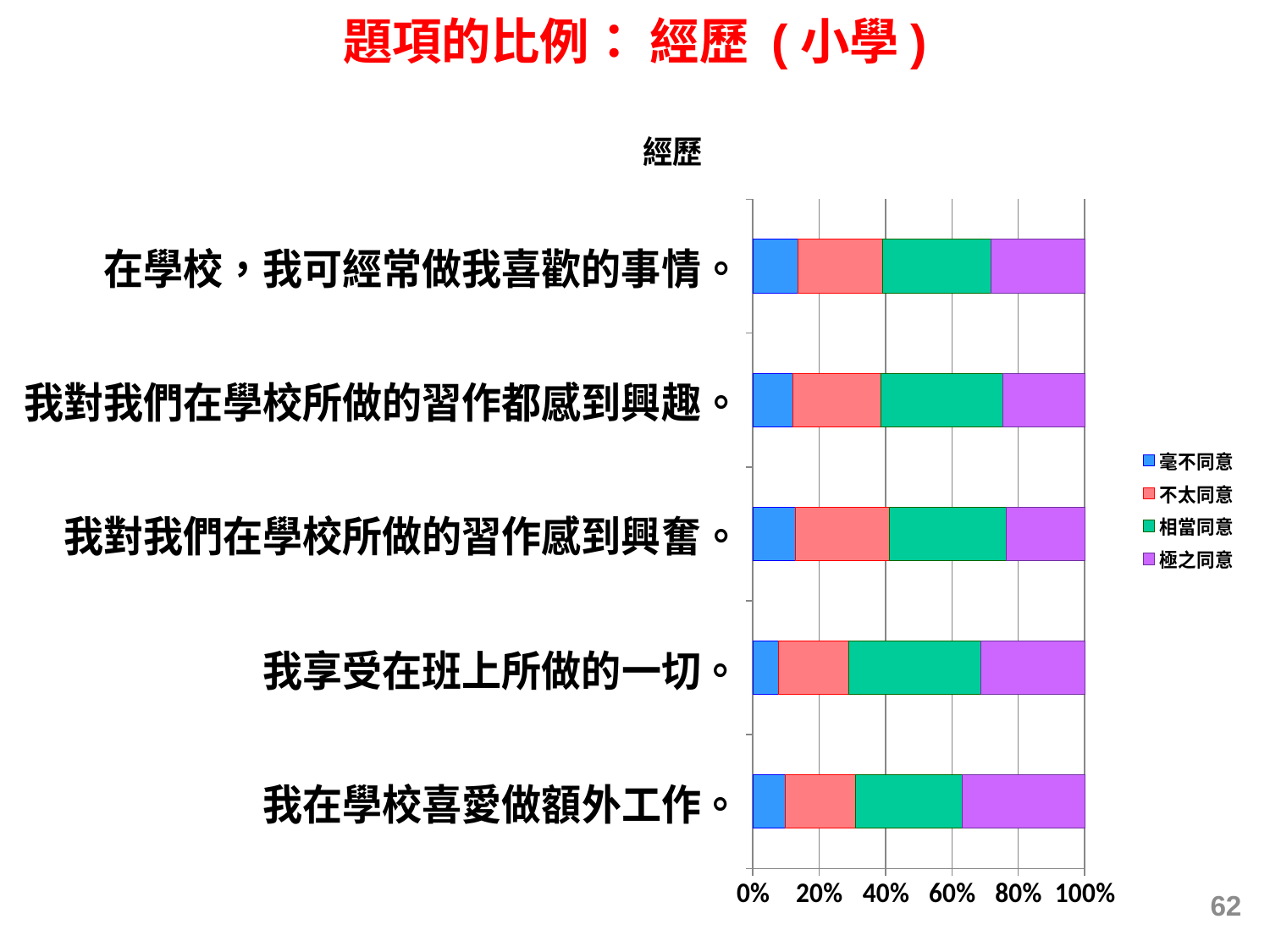
Which has the larger 毫不同意 share: 在學校，我可經常做我喜歡的事情 or 我享受在班上所做的一切? 在學校，我可經常做我喜歡的事情 How many series does the legend list? 4 Which statement has the largest 極之同意 share? 我在學校喜愛做額外工作 Which has the larger 極之同意 share: 我在學校喜愛做額外工作 or 我對我們在學校所做的習作都感到興趣? 我在學校喜愛做額外工作 Is the 極之同意 value for 我在學校喜愛做額外工作 greater or less than 20%? greater Is the 毫不同意 value for 在學校，我可經常做我喜歡的事情 greater or less than 20%? less How many statements (categories) are plotted in the chart? 5 Which legend entry is shown in purple? 極之同意 What is the title of the chart? 經歷 What kind of chart is shown on the slide? stacked bar chart Is the 毫不同意 value for 我享受在班上所做的一切 greater or less than 20%? less